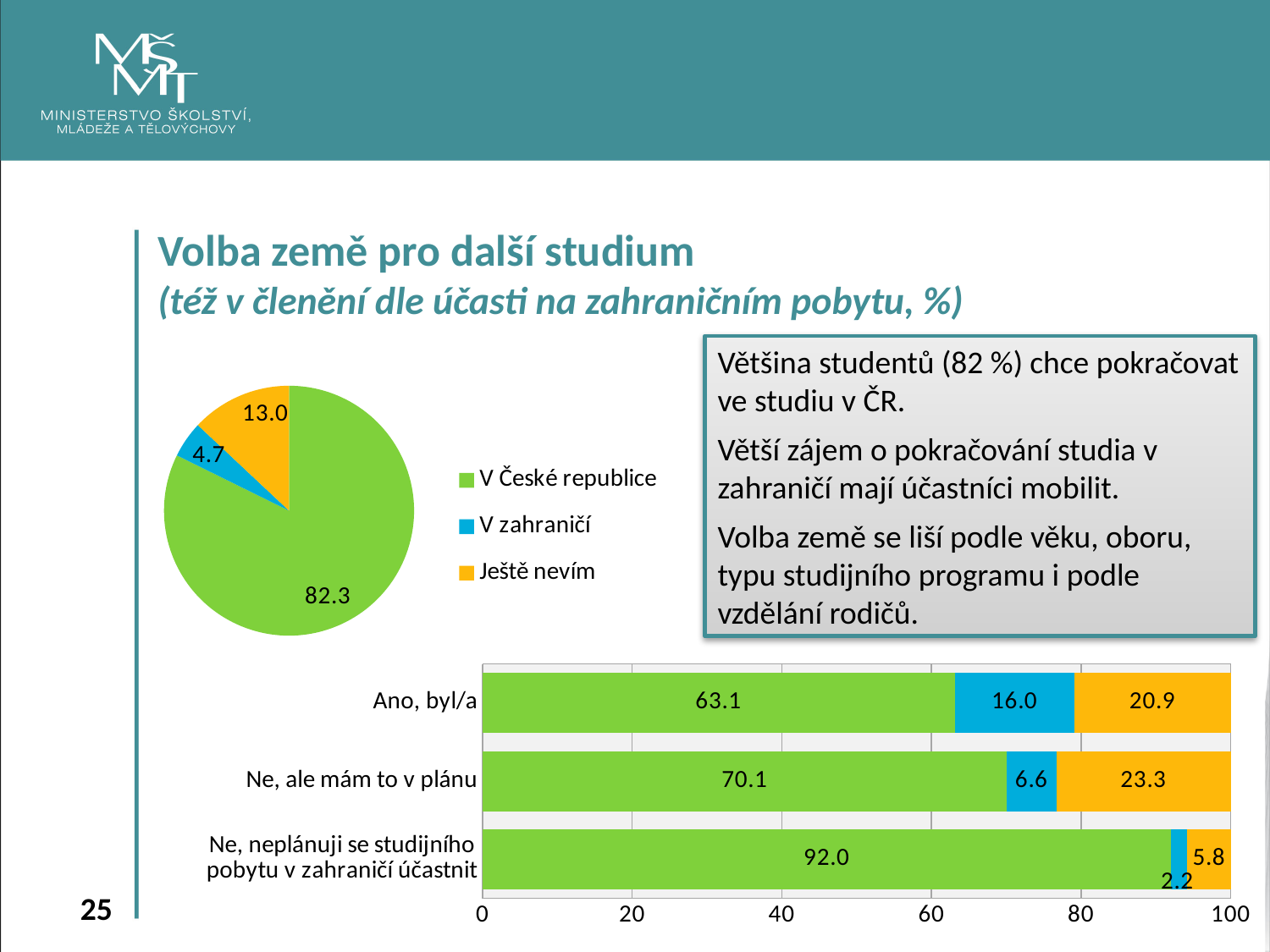
How many entries does the pie chart's legend list? 3 In the pie chart, what share is labelled for 'V České republice'? 82.3 In the pie chart, what share is labelled for 'V zahraničí'? 4.7 In the bottom bar chart, what is the green (V České republice) value for 'Ano, byl/a'? 63.1 How many categories does the bottom bar chart show? 3 What kind of chart is the chart at the top left of the slide? pie chart In the bottom bar chart, what is the orange (Ještě nevím) value for 'Ne, neplánuji se studijního pobytu v zahraničí účastnit'? 5.8 In the bottom bar chart, what is the difference between the blue (V zahraničí) values for 'Ano, byl/a' and 'Ne, ale mám to v plánu'? 9.4 In the pie chart, which slice is the smallest? V zahraničí In the bottom bar chart, which category has the highest green (V České republice) value? Ne, neplánuji se studijního pobytu v zahraničí účastnit What kind of chart is the chart at the bottom of the slide? bar chart In the bottom bar chart, what is the blue (V zahraničí) value for 'Ne, ale mám to v plánu'? 6.6